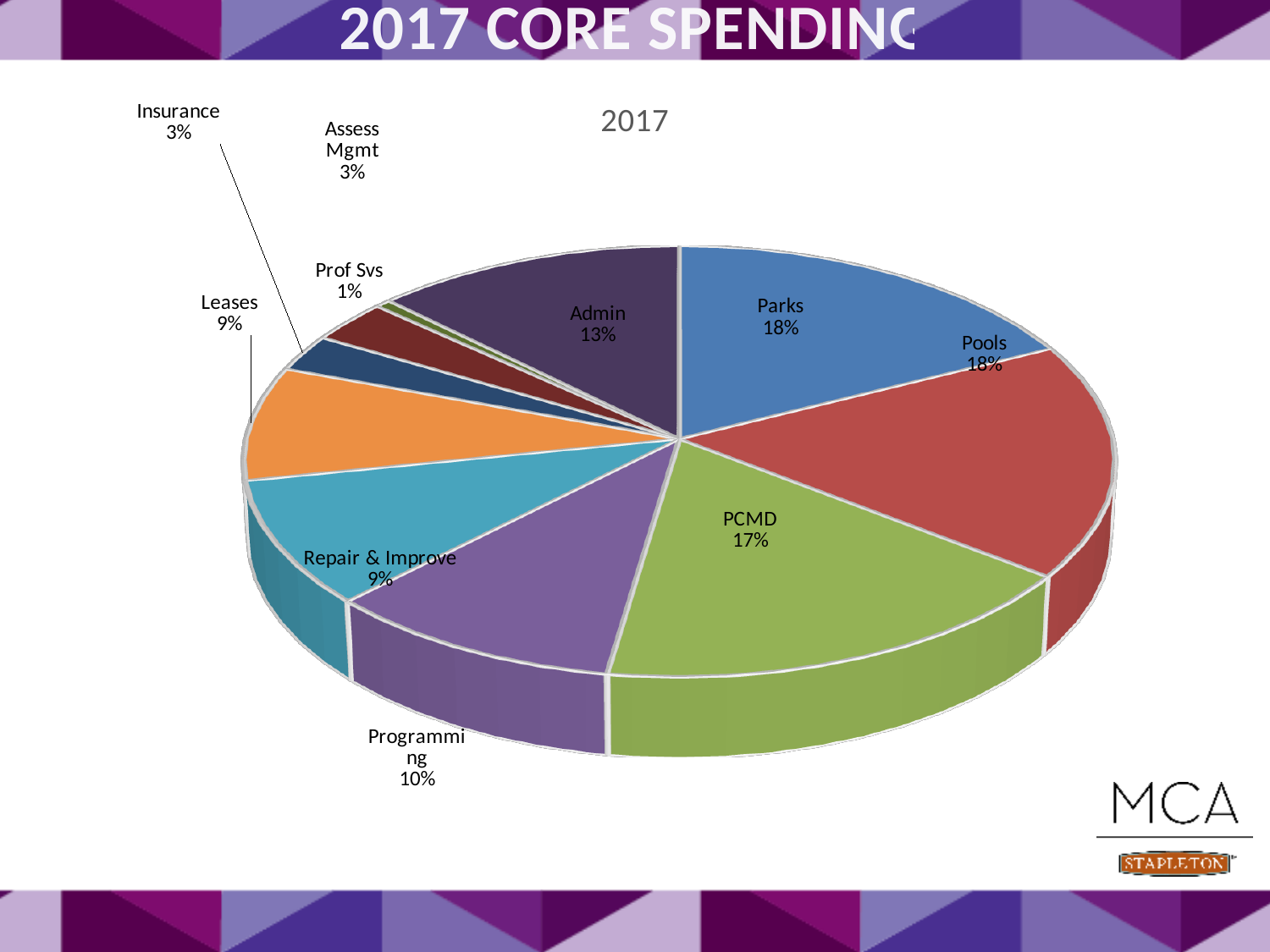
What type of chart is shown on the slide? pie chart How many categories are labeled in the pie chart? 10 Which category has the smallest slice of the pie? Prof Svs What percentage is shown for Insurance? 3% What percentage is shown for Leases? 9% What is the difference in percentage points between Admin and Programming? 3% What is the title of the chart? 2017 What percentage is shown for PCMD? 17% Which is larger, the share for Pools or the share for PCMD? Pools What percentage is shown for Programming? 10% What percentage is shown for Admin? 13% What share of 2017 core spending goes to Parks? 18%